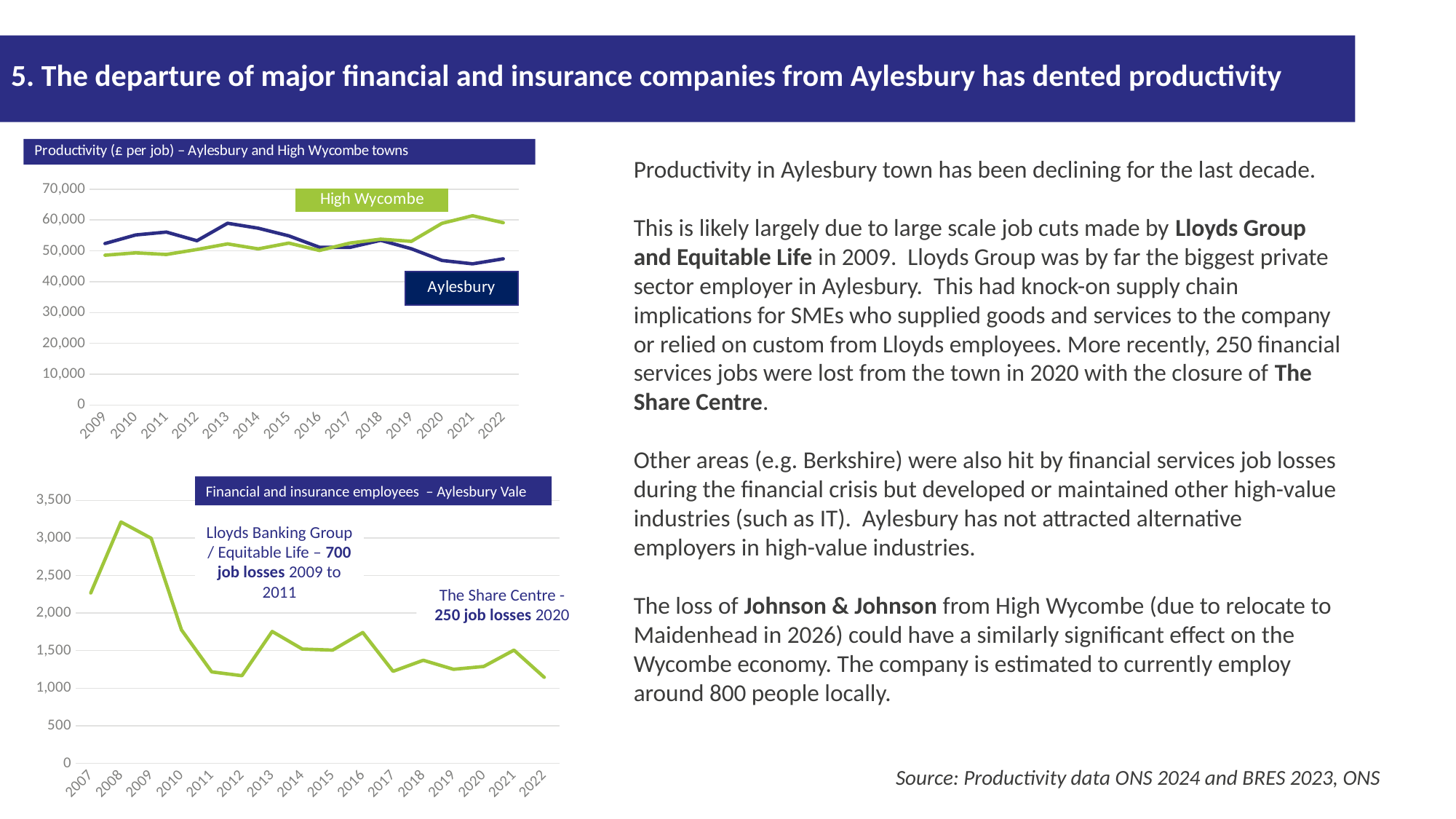
In the bottom chart 'Financial and insurance employees – Aylesbury Vale', how many years are shown on the x axis? 16 In the top productivity chart, is the value for Aylesbury in 2022 greater or less than 50,000? less What kind of chart is the top chart titled 'Productivity (£ per job) – Aylesbury and High Wycombe towns'? Line chart In the top productivity chart, is the value for High Wycombe in 2021 greater or less than 60,000? greater In the bottom chart 'Financial and insurance employees – Aylesbury Vale', which year has the highest number of employees? 2008 In the top productivity chart, does the Aylesbury line rise or fall between 2018 and 2021? Fall In the top productivity chart, how many years are shown on the x axis? 14 In the top productivity chart, how many series are plotted? 2 In the top productivity chart, which town has the higher productivity in 2009, Aylesbury or High Wycombe? Aylesbury What is the title of the bottom chart on the slide? Financial and insurance employees – Aylesbury Vale In the top productivity chart, which town has the higher productivity in 2022, Aylesbury or High Wycombe? High Wycombe In the bottom chart 'Financial and insurance employees – Aylesbury Vale', is the value for 2008 greater or less than 3,000? greater